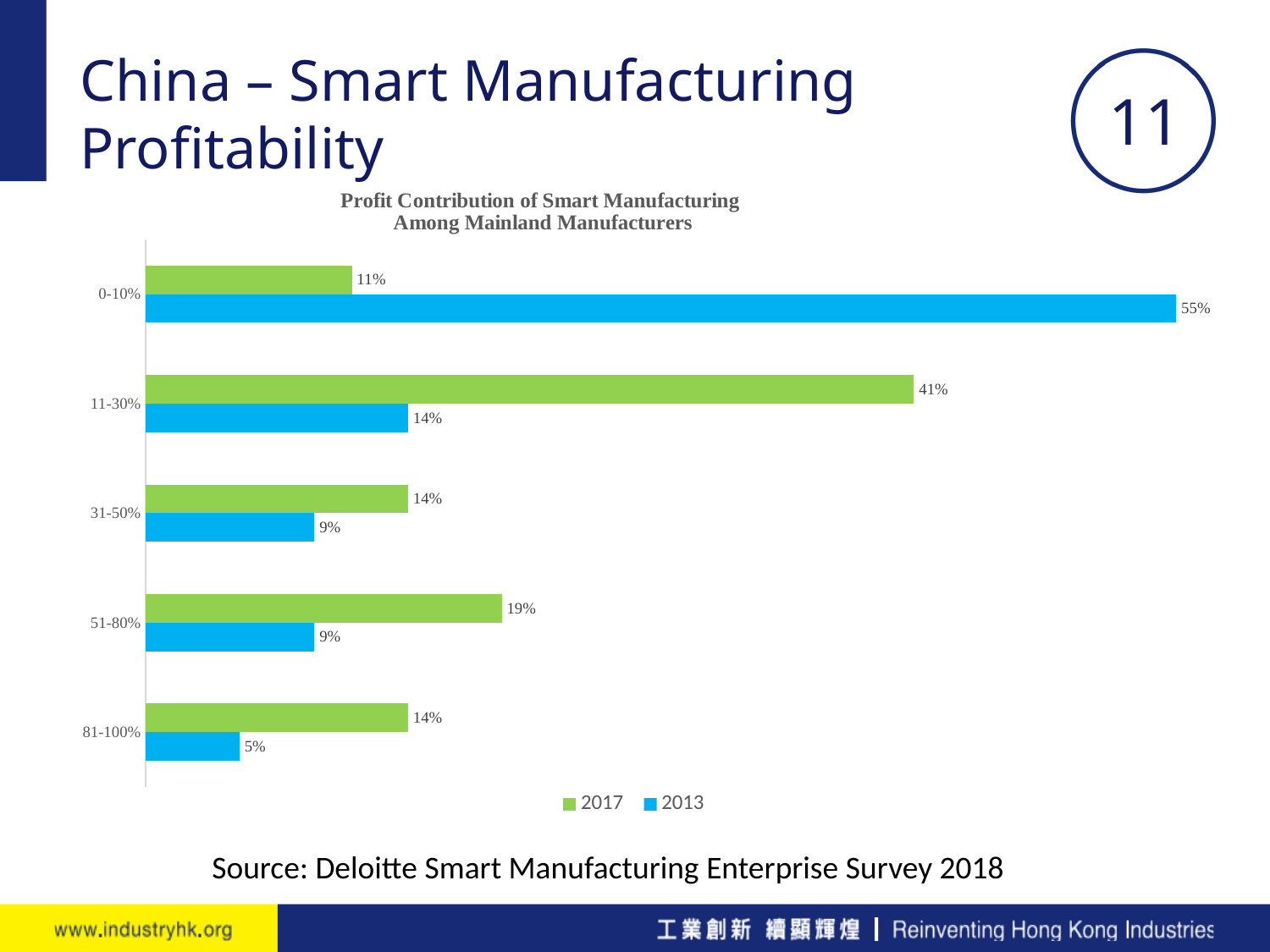
What is the 2017 value for the 51-80% category? 19% What kind of chart is shown on the slide? Bar chart What is the title of the chart? Profit Contribution of Smart Manufacturing Among Mainland Manufacturers Which is larger for the 31-50% category, the 2017 value or the 2013 value? 2017 What is the difference between the 2013 and 2017 values for the 0-10% category? 44% What is the 2013 value for the 0-10% category? 55% How many categories are shown on the chart? 5 Which category has the lowest 2013 value? 81-100% What is the 2017 value for the 11-30% category? 41% How many series does the legend list? 2 What is the 2013 value for the 81-100% category? 5% Which category has the highest 2017 value? 11-30%